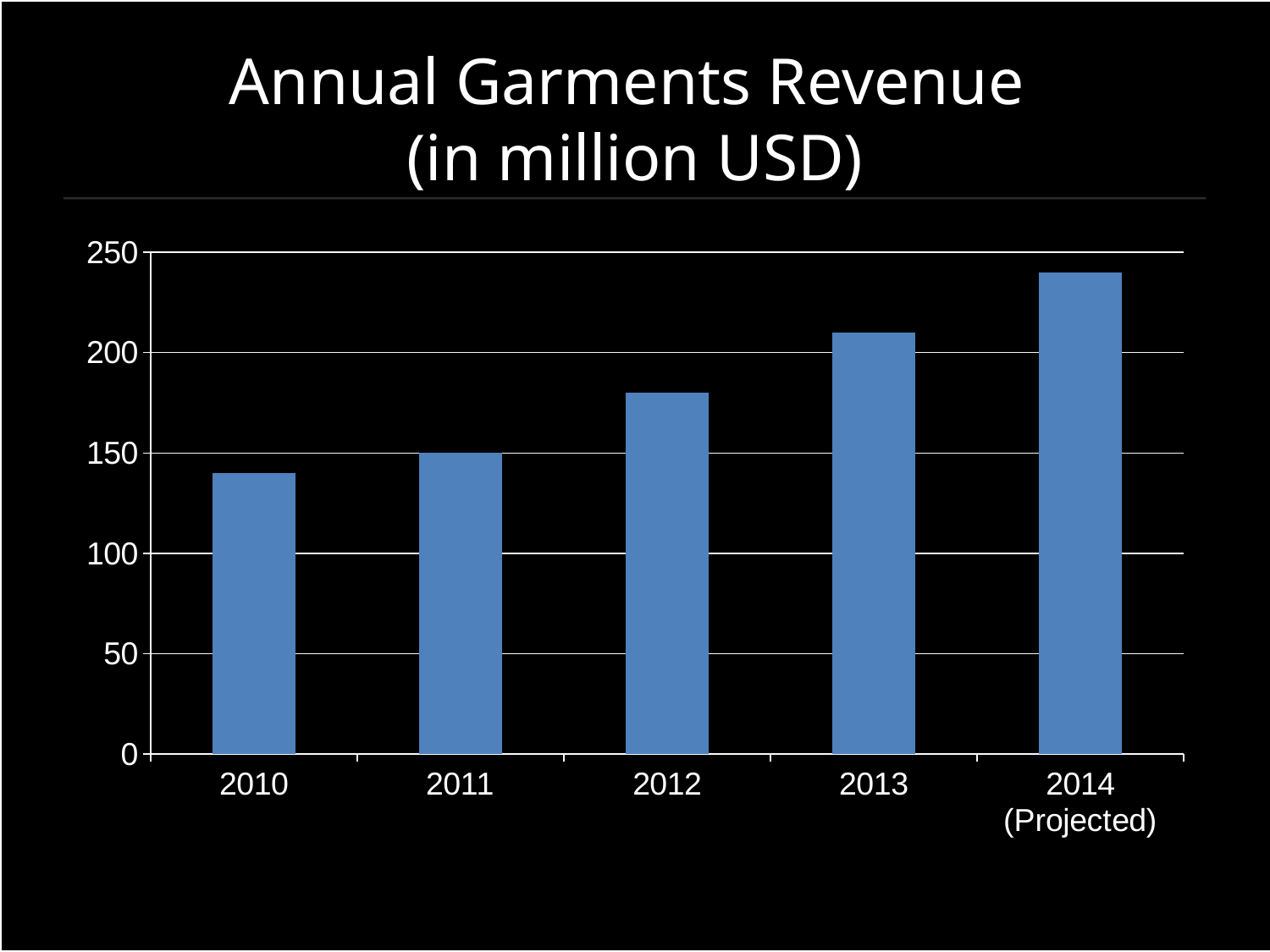
Which year has the lowest revenue? 2010 Which year has the highest revenue? 2014 (Projected) Do the revenue values rise or fall from 2010 to 2014? rise Is the value for 2012 greater or less than 150? greater How many years are shown on the x axis of the chart? 5 What is the revenue value for 2011? 150 Is the value for 2013 greater or less than 200? greater Which is larger, the value for 2012 or the value for 2013? 2013 What kind of chart is shown on the slide? bar chart Is the value for 2010 greater or less than 150? less What is the title of the chart? Annual Garments Revenue (in million USD)